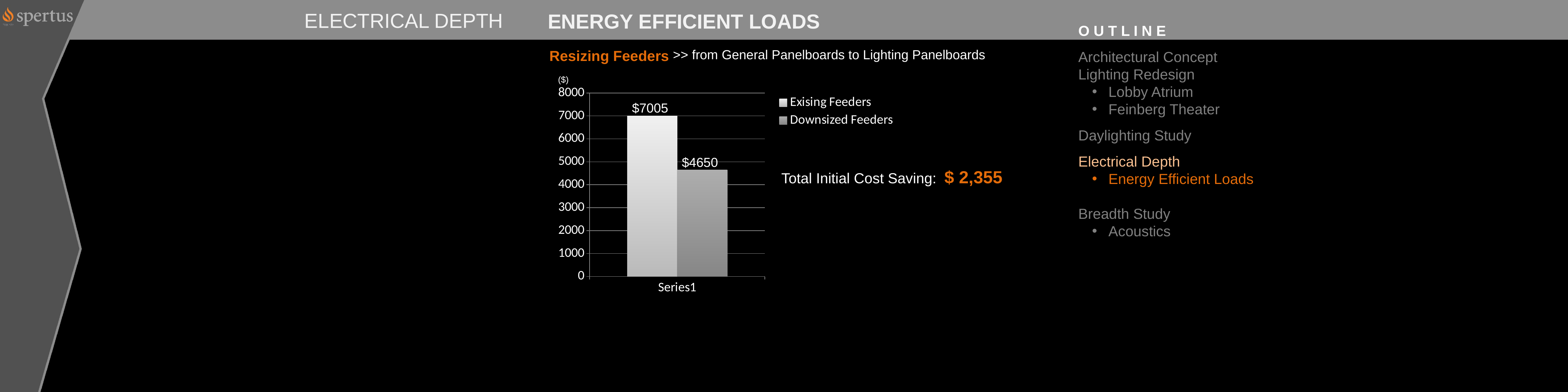
What kind of chart is shown? bar chart What is the maximum value shown on the y axis? 8000 What is the difference between the Exising Feeders and Downsized Feeders values? $2355 Is the value for Downsized Feeders greater or less than 5000? less How many series does the legend list? 2 Is the value for Exising Feeders greater or less than 6000? greater Which series has the lowest value? Downsized Feeders What is the category label on the x axis? Series1 Which series has the higher value, Exising Feeders or Downsized Feeders? Exising Feeders What is the value for Exising Feeders? $7005 What is the value for Downsized Feeders? $4650